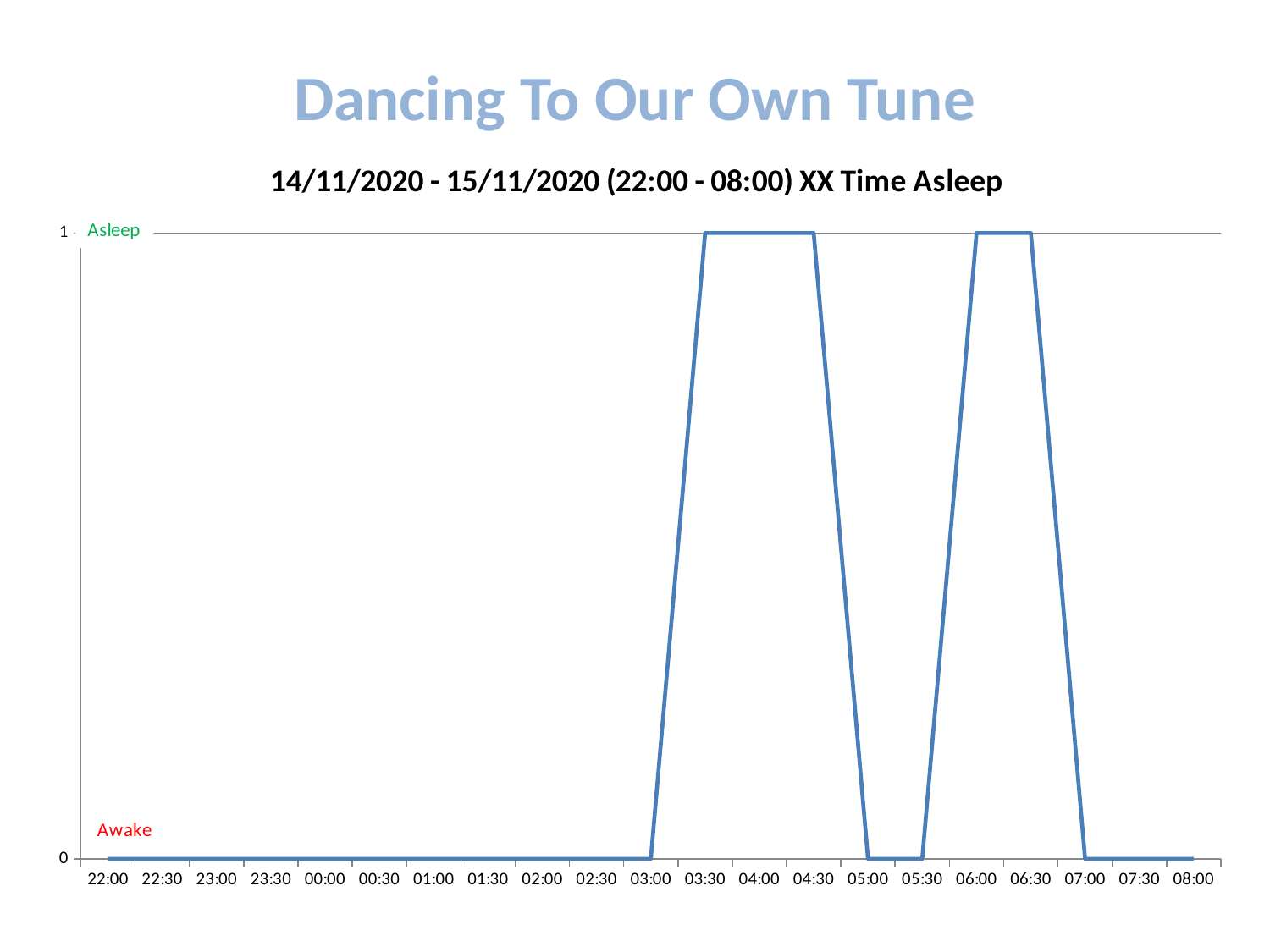
What is the value at 05:30? 0 How many time points are shown on the x axis? 21 What label is shown next to the value 1 on the y axis? Asleep What is the value at 04:00? 1 What is the value at 06:30? 1 Which is larger, the value at 03:30 or the value at 05:00? 03:30 What is the value at 22:00? 0 Does the line rise or fall between 04:30 and 05:00? Fall What is the difference between the value at 06:00 and the value at 07:00? 1 What is the chart's title? 14/11/2020 - 15/11/2020 (22:00 - 08:00) XX Time Asleep What is the value at 08:00? 0 What type of chart is shown on the slide? Line chart